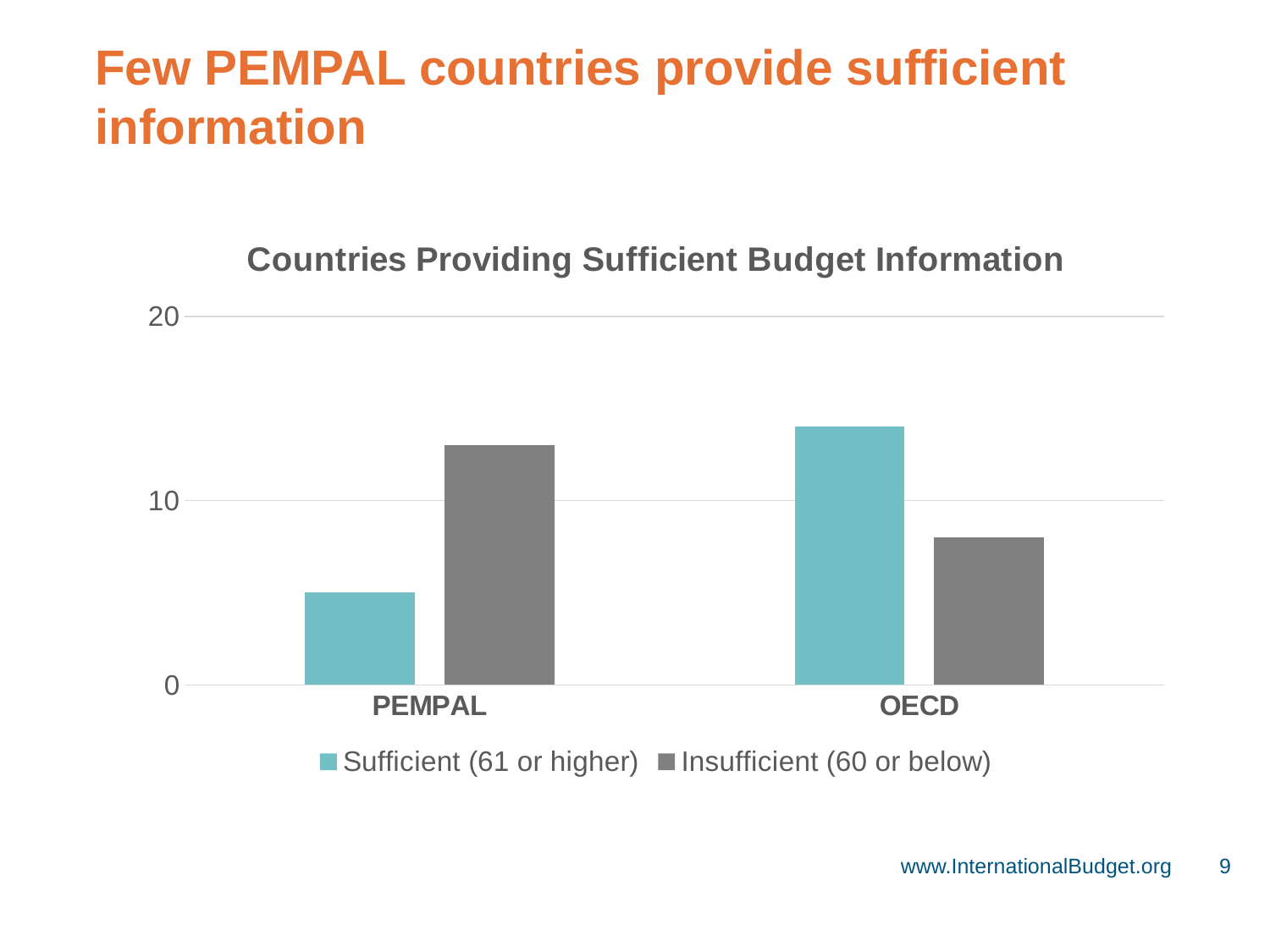
Is the value for Sufficient (61 or higher) in OECD greater or less than 10? greater Is the value for Insufficient (60 or below) in OECD greater or less than 10? less Is the value for Insufficient (60 or below) in PEMPAL greater or less than 10? greater What kind of chart is shown on the slide? bar chart Which bar is the lowest in the chart? Sufficient (61 or higher) for PEMPAL For OECD, which is larger: Sufficient (61 or higher) or Insufficient (60 or below)? Sufficient (61 or higher) For PEMPAL, which is larger: Sufficient (61 or higher) or Insufficient (60 or below)? Insufficient (60 or below) How many series does the legend list? 2 How many categories are shown on the x axis? 2 What is the title of the chart? Countries Providing Sufficient Budget Information Which colour represents the Sufficient (61 or higher) series? teal